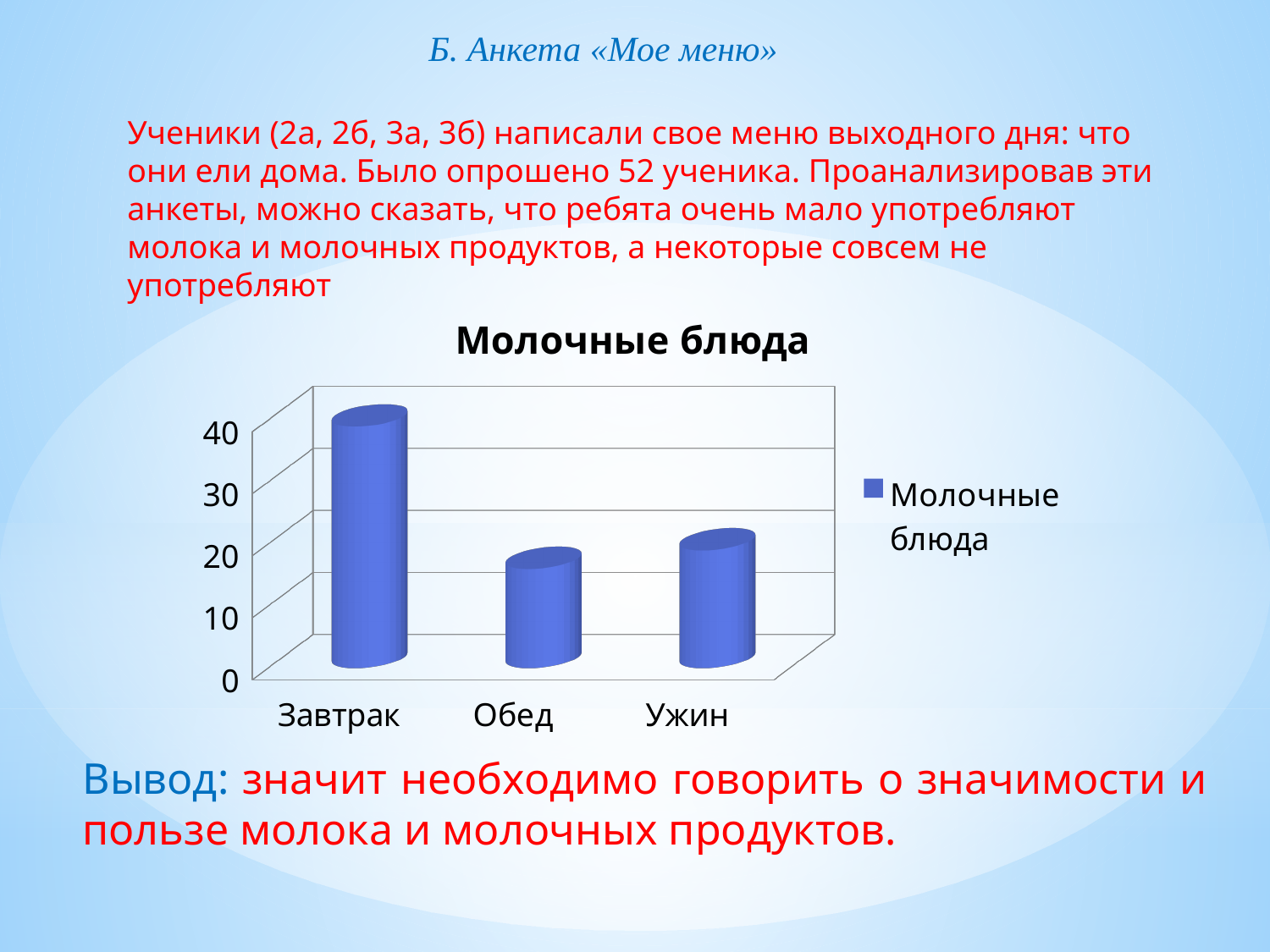
How many categories are shown on the x axis of the chart? 3 What is the title of the chart? Молочные блюда Is the value for Ужин greater or less than 10? greater Which category has the lowest value in the chart? Обед What kind of chart is shown on the slide? bar chart Is the value for Обед greater or less than 30? less Which category has the highest value in the chart? Завтрак How many series does the chart legend list? 1 Which has a larger value, Завтрак or Ужин? Завтрак Is the value for Завтрак greater or less than 30? greater Which has a larger value, Обед or Ужин? Ужин What is the name of the series listed in the chart legend? Молочные блюда